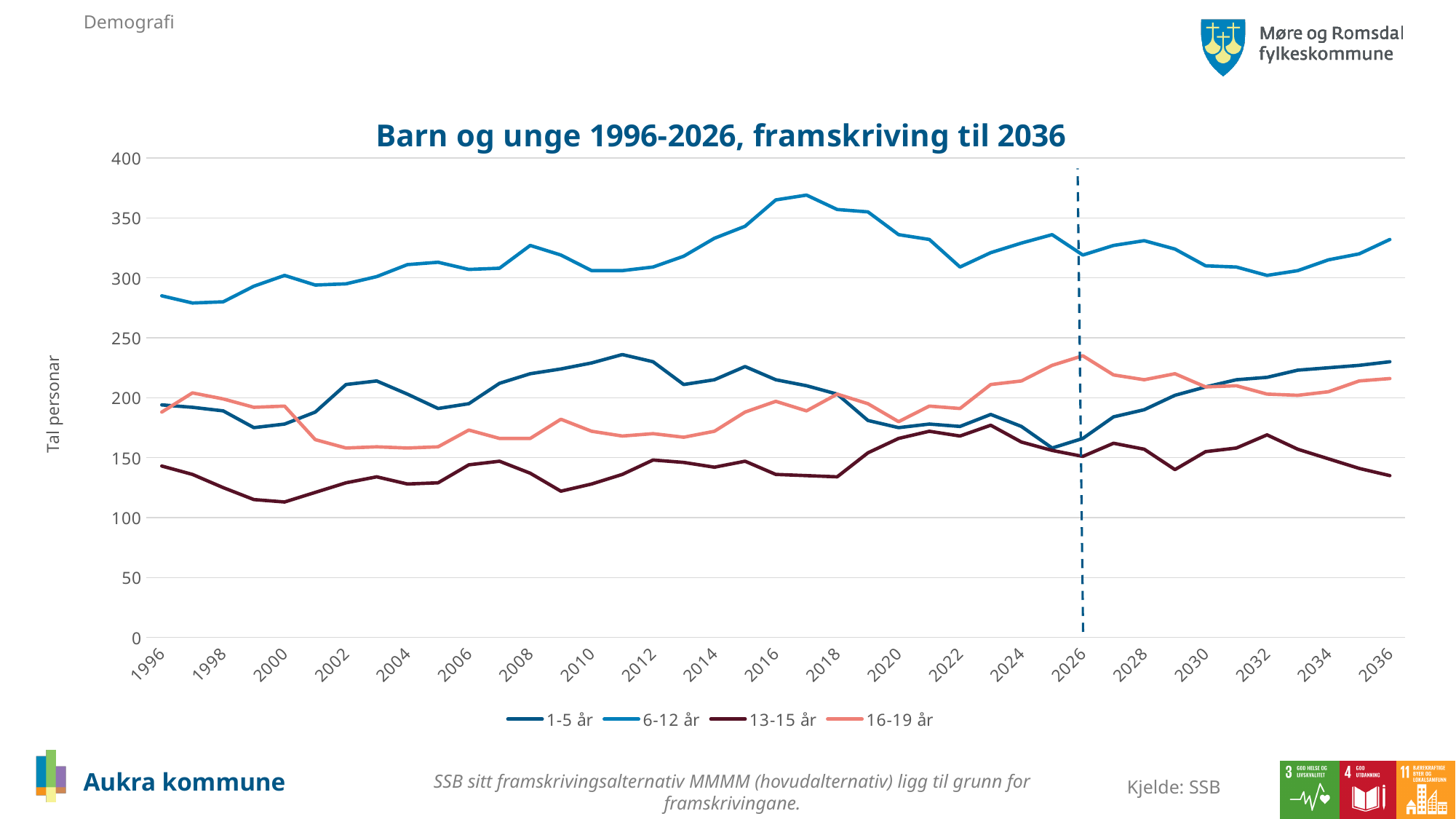
Which age group has the lowest value in 1996? 13-15 år What is the label on the vertical axis? Tal personar In 2010, which is larger: the value for 1-5 år or the value for 16-19 år? 1-5 år What is the title of the chart? Barn og unge 1996-2026, framskriving til 2036 In 2026, which is larger: the value for 1-5 år or the value for 16-19 år? 16-19 år Is the value for 16-19 år in 2026 greater or less than 200? greater Is the value for 13-15 år in 2000 greater or less than 150? less Is the value for 6-12 år in 2017 greater or less than 350? greater How many series does the legend list? 4 Does the 13-15 år line rise or fall from 2032 to 2036? fall What kind of chart is shown on the slide? line chart Which age group has the highest value in 2016? 6-12 år